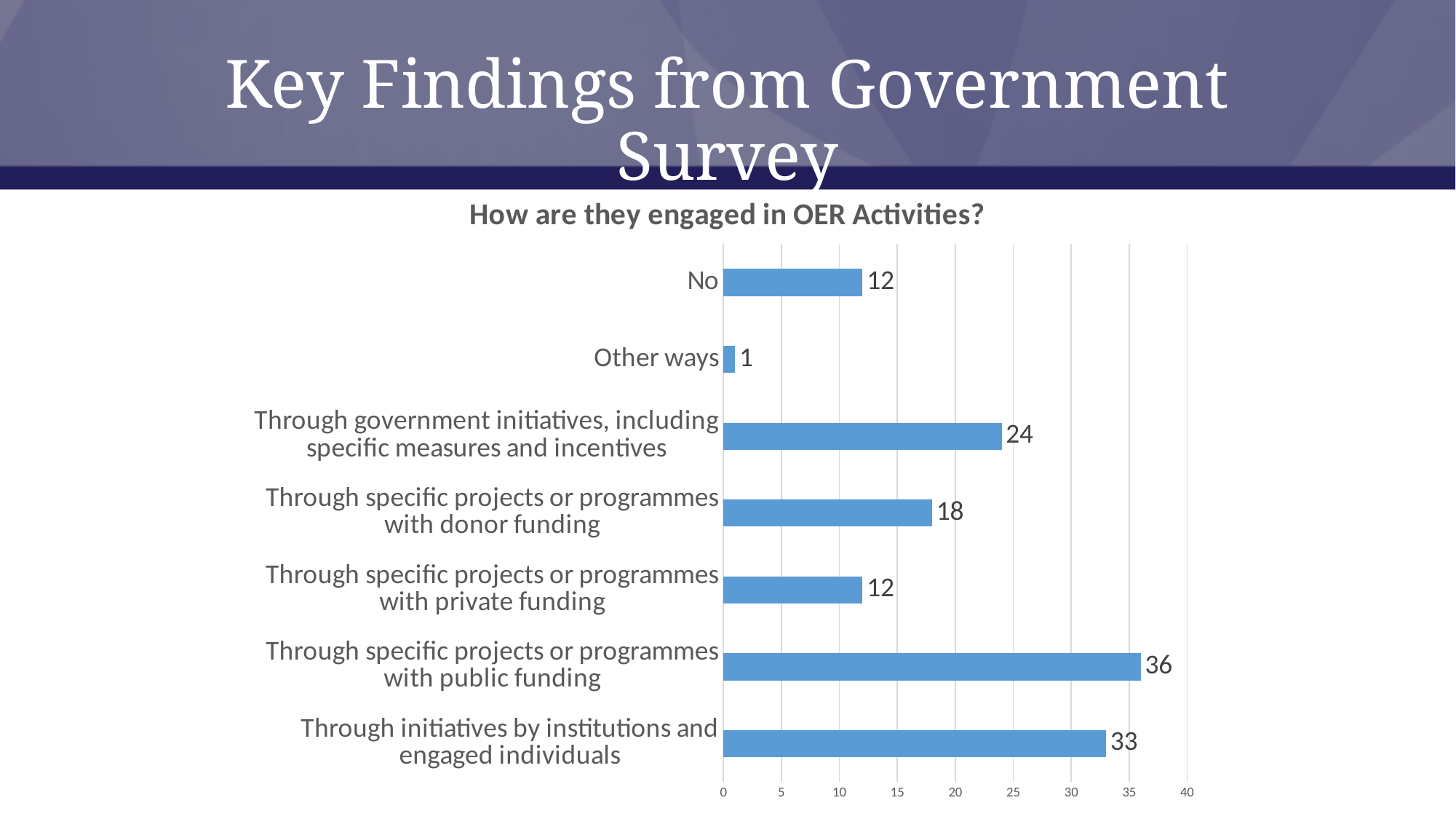
What is the value for 'No'? 12 What is the difference between the values for 'Through specific projects or programmes with public funding' and 'Through initiatives by institutions and engaged individuals'? 3 What is the value for 'Through government initiatives, including specific measures and incentives'? 24 Which category has the highest value? Through specific projects or programmes with public funding What is the title of the chart? How are they engaged in OER Activities? What kind of chart is shown on the slide? Bar chart Which category has the lowest value? Other ways What is the value for 'Through specific projects or programmes with public funding'? 36 Which is larger: the value for 'Through specific projects or programmes with donor funding' or the value for 'Through specific projects or programmes with private funding'? Through specific projects or programmes with donor funding What is the value for 'Other ways'? 1 What is the difference between the values for 'Through government initiatives, including specific measures and incentives' and 'Through specific projects or programmes with donor funding'? 6 How many categories are shown in the chart? 7